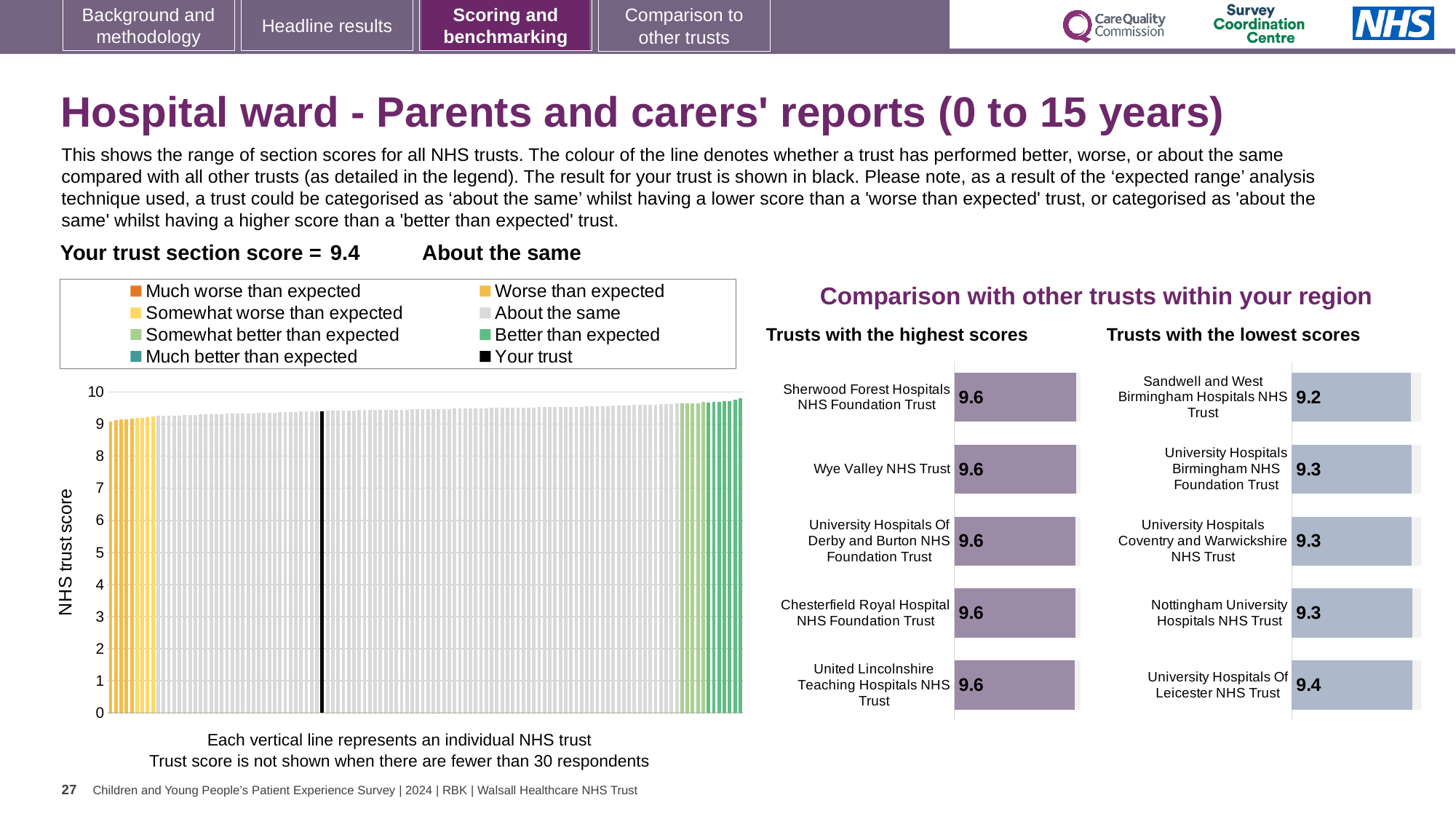
In the 'Trusts with the lowest scores' chart, which trust has the highest score? University Hospitals Of Leicester NHS Trust In the 'Trusts with the lowest scores' chart, what is the difference between the scores of University Hospitals Of Leicester NHS Trust and Sandwell and West Birmingham Hospitals NHS Trust? 0.2 In the 'Trusts with the lowest scores' chart, which trust has the lowest score? Sandwell and West Birmingham Hospitals NHS Trust In the large chart on the left, is the value for your trust (the black line) greater or less than 5? greater In the 'Trusts with the lowest scores' chart, which has the larger score: Nottingham University Hospitals NHS Trust or University Hospitals Of Leicester NHS Trust? University Hospitals Of Leicester NHS Trust In the 'Trusts with the lowest scores' chart, what is the score for Sandwell and West Birmingham Hospitals NHS Trust? 9.2 In the large chart on the left, do the trust scores rise or fall from left to right? Rise How many entries does the legend above the large chart on the left list? 8 What is the trust section score shown on the slide for your trust? 9.4 In the 'Trusts with the highest scores' chart, what is the score for Wye Valley NHS Trust? 9.6 How many trusts are listed in the 'Trusts with the highest scores' chart? 5 What kind of chart is the large chart on the left showing NHS trust scores? Bar chart